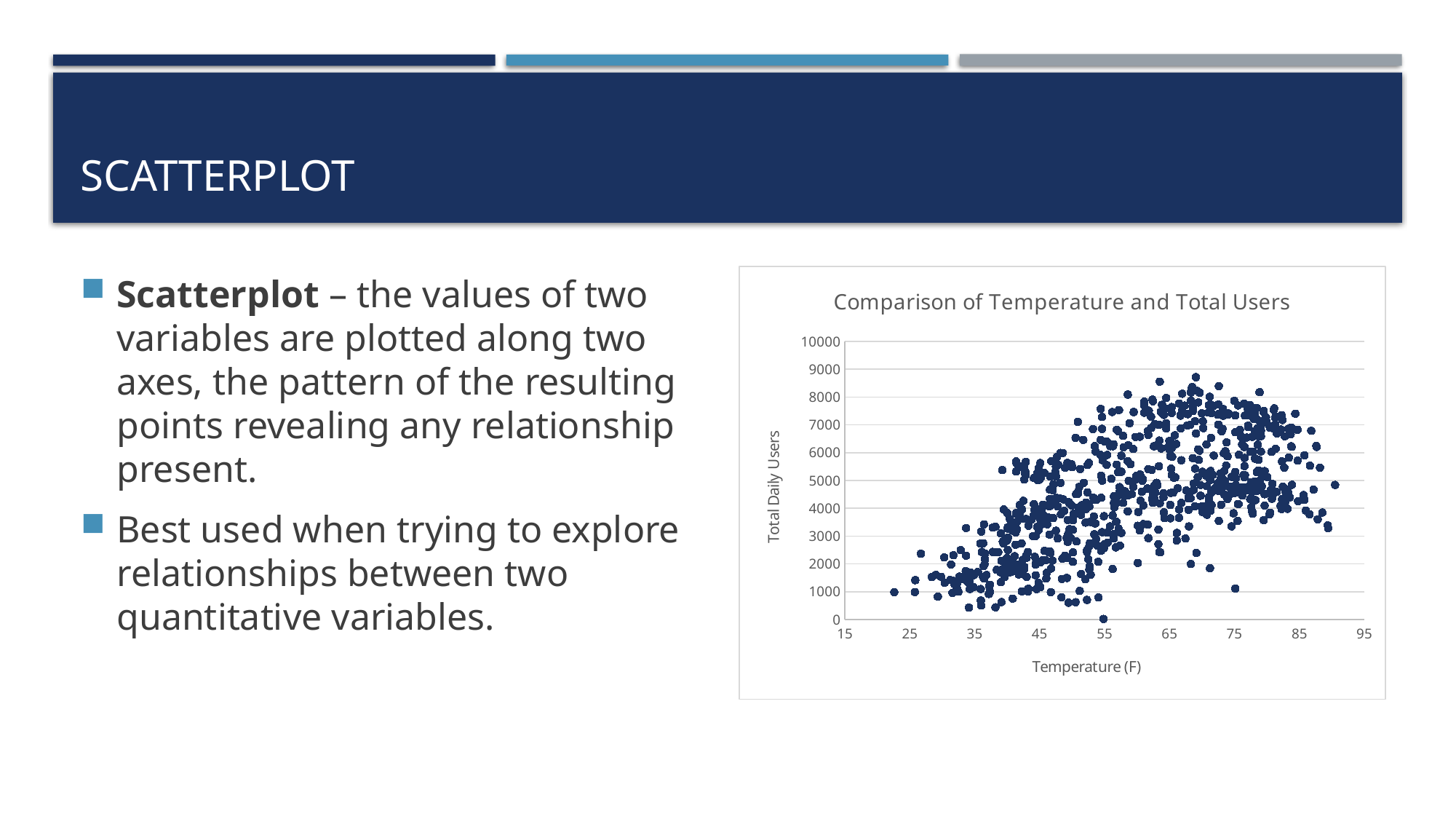
What is the label of the x axis of the chart? Temperature (F) Is the highest Total Daily Users value plotted greater or less than 9000? less What kind of chart is shown on the slide? Scatter plot What is the maximum value shown on the y axis of the chart? 10000 Is the lowest Total Daily Users value plotted greater or less than 1000? less What is the title of the chart? Comparison of Temperature and Total Users Is the highest Total Daily Users value plotted greater or less than 8000? greater Do the Total Daily Users values generally rise or fall as Temperature increases along the x axis? Rise